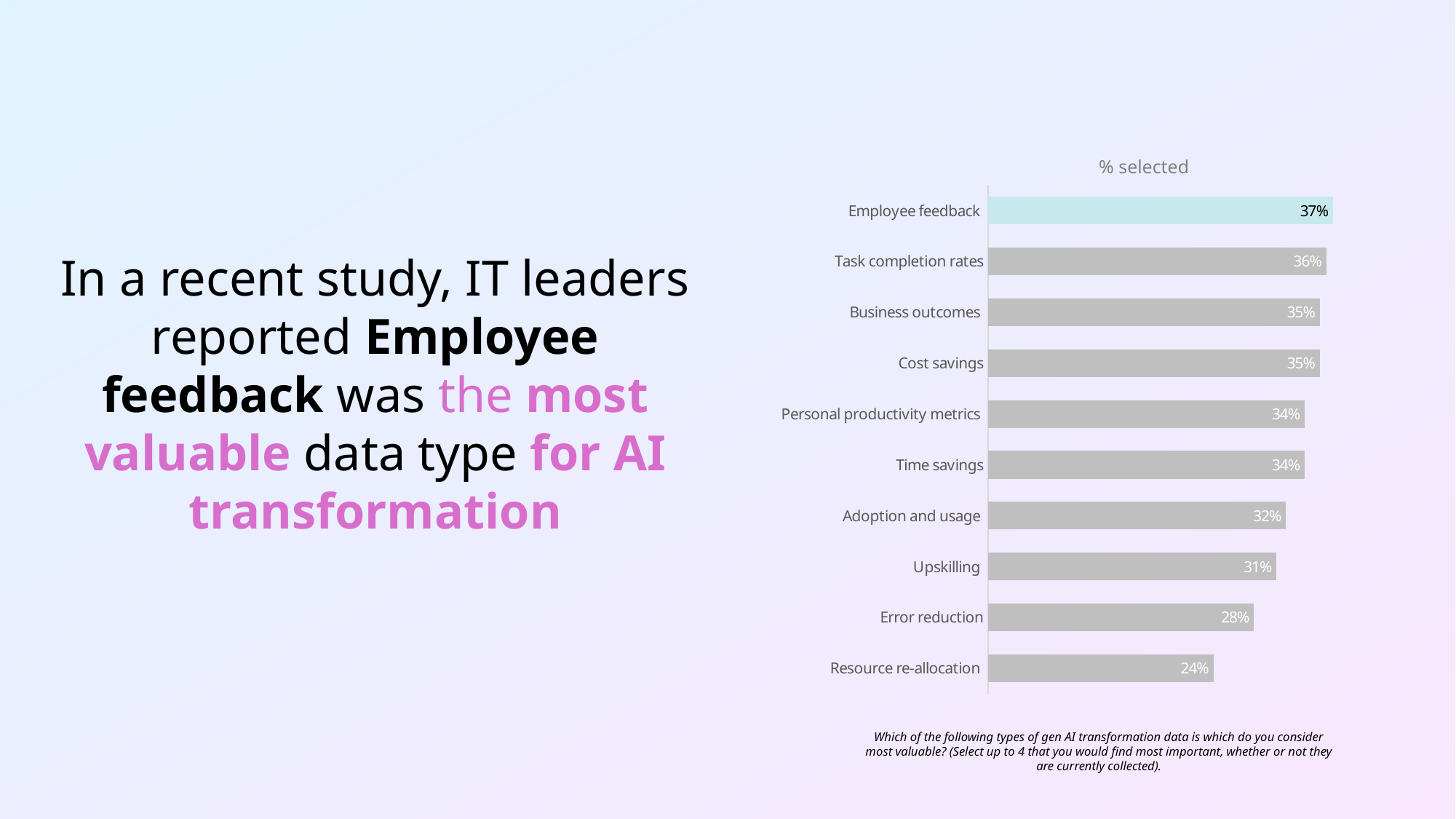
What percentage selected Adoption and usage? 32% Which is larger, Task completion rates or Error reduction? Task completion rates What is the value for Resource re-allocation? 24% What is the title of the chart? % selected How many categories are shown in the chart? 10 Which category has the highest percentage selected? Employee feedback Which category has the lowest percentage selected? Resource re-allocation Which bar is highlighted in a different colour from the others? Employee feedback What is the difference between Employee feedback and Resource re-allocation? 13% What kind of chart is shown on the slide? Bar chart What is the difference between Upskilling and Error reduction? 3% What percentage selected Employee feedback? 37%